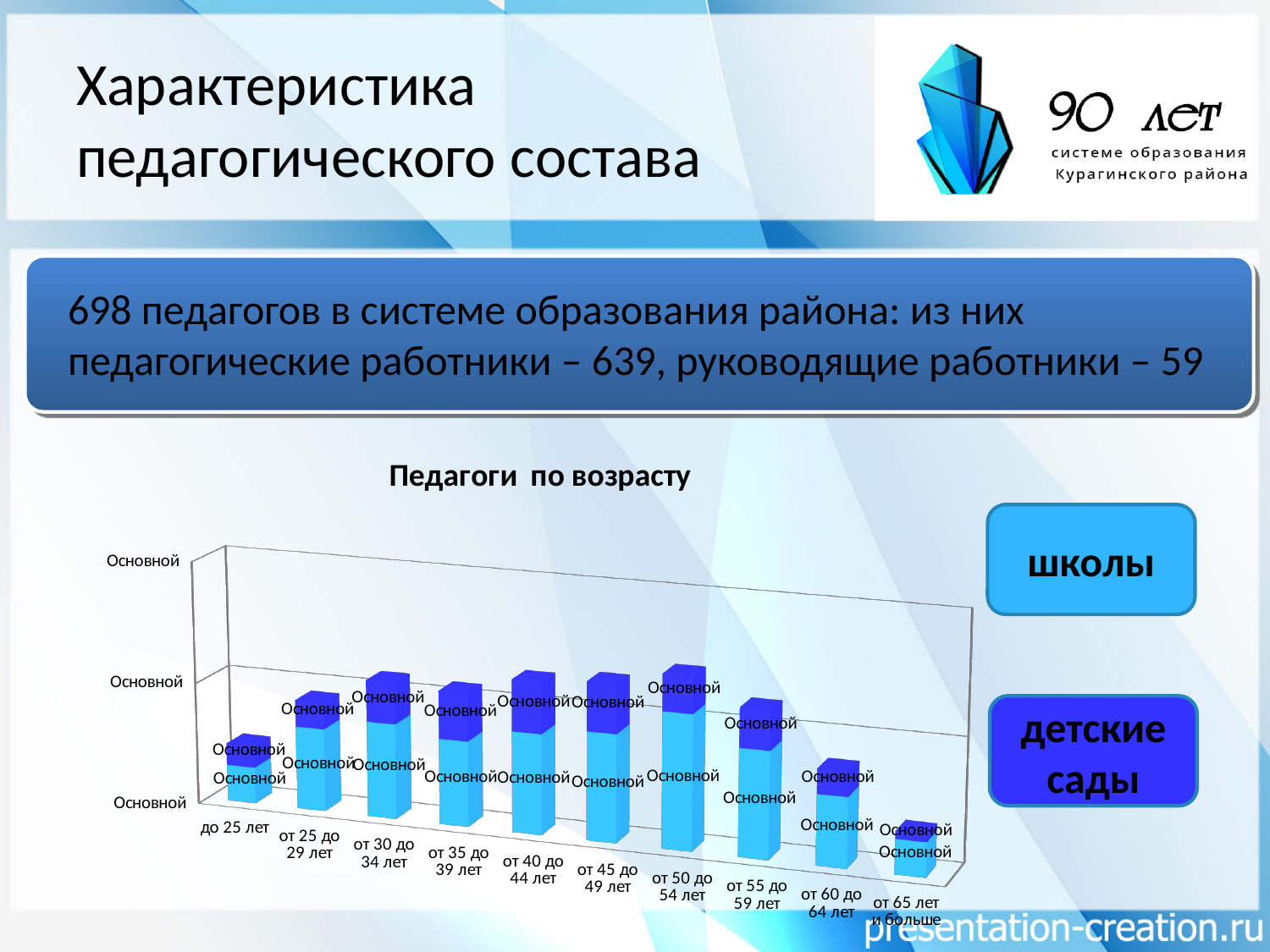
What is the title of the chart on the slide? Педагоги по возрасту In the "Педагоги по возрасту" chart, which stacked bar is taller: от 50 до 54 лет or от 65 лет и больше? от 50 до 54 лет Which age category has the shortest stacked bar in the "Педагоги по возрасту" chart? от 65 лет и больше What is the first age category on the x axis of the "Педагоги по возрасту" chart? до 25 лет How many age categories are shown on the x axis of the "Педагоги по возрасту" chart? 10 In the "Педагоги по возрасту" chart, which stacked bar is taller: от 55 до 59 лет or от 60 до 64 лет? от 55 до 59 лет In the "Педагоги по возрасту" chart, which stacked bar is taller: до 25 лет or от 30 до 34 лет? от 30 до 34 лет What kind of chart is "Педагоги по возрасту"? bar chart In the "Педагоги по возрасту" chart, do the stacked bars fall steadily from от 50 до 54 лет to от 65 лет и больше? yes, they fall Which two series are shown in the "Педагоги по возрасту" chart? школы and детские сады How many series does the "Педагоги по возрасту" chart show? 2 Which age category has the tallest stacked bar in the "Педагоги по возрасту" chart? от 50 до 54 лет